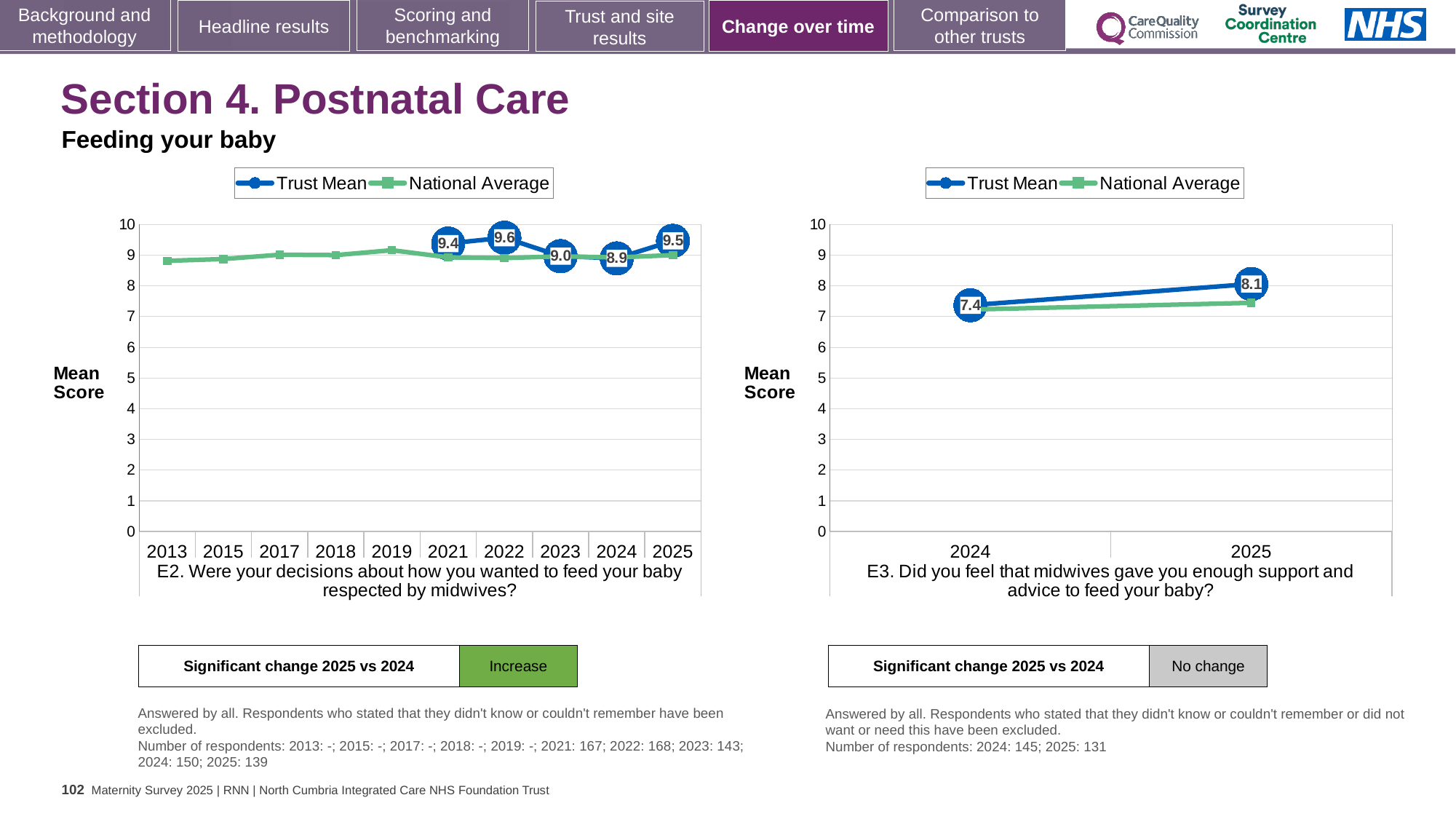
In the left chart (E2), which year has the highest labelled Trust Mean? 2022 In the left chart (E2), what is the Trust Mean for 2025? 9.5 In the left chart (E2), what is the Trust Mean for 2024? 8.9 In the left chart (E2), what is the difference between the Trust Mean for 2025 and 2024? 0.6 In the left chart (E2), which year has the lowest labelled Trust Mean? 2024 In the right chart (E3), is the National Average for 2025 greater or less than 8? less In the left chart (E2), what is the Trust Mean for 2022? 9.6 How many series does the legend of the right chart (E3) list? 2 In the right chart (E3), does the Trust Mean rise or fall from 2024 to 2025? rise In the right chart (E3), what is the Trust Mean for 2025? 8.1 In the right chart (E3), what is the Trust Mean for 2024? 7.4 In the left chart (E2), how many years are shown on the x axis? 10